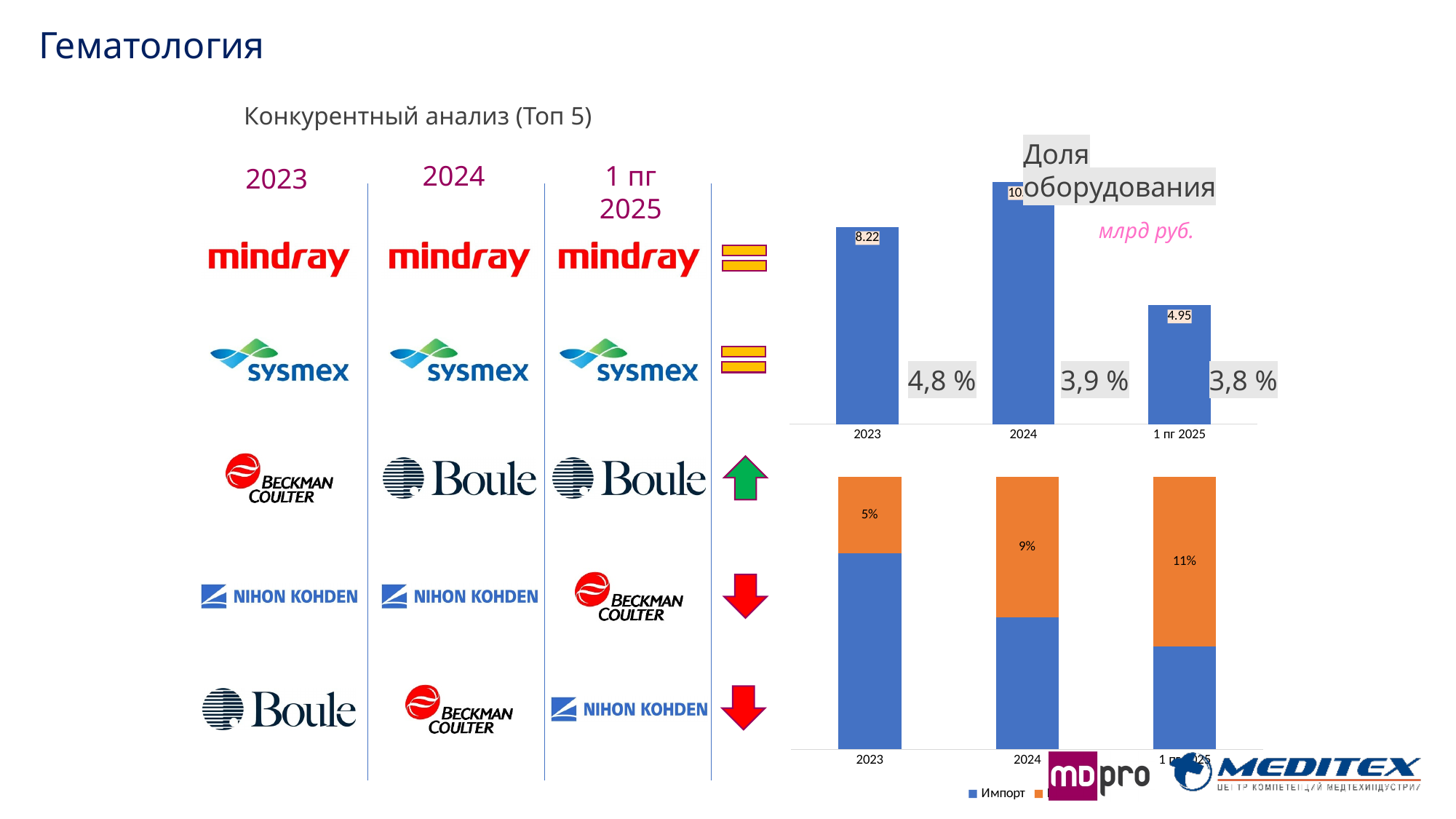
In the top chart (млрд руб.), what is the value for 2023? 8.22 In the top chart (млрд руб.), what is the value for 1 пг 2025? 4.95 In the bottom stacked chart, which period has the largest orange segment? 1 пг 2025 What kind of chart is the top chart on the right side of the slide? Bar chart In the bottom stacked chart, does the orange segment's share rise or fall from 2023 to 1 пг 2025? Rise In the top chart (млрд руб.), which period has the lowest bar? 1 пг 2025 In the top chart (млрд руб.), what is the difference between the 2023 value and the 1 пг 2025 value? 3.27 In the top chart (млрд руб.), which is larger: the value for 2023 or the value for 1 пг 2025? 2023 In the bottom stacked chart, what is the label on the orange segment for 2024? 9% In the bottom stacked chart, what is the label on the orange segment for 1 пг 2025? 11% In the top chart (млрд руб.), which period has the highest bar? 2024 In the top chart (млрд руб.), how many bars are plotted? 3